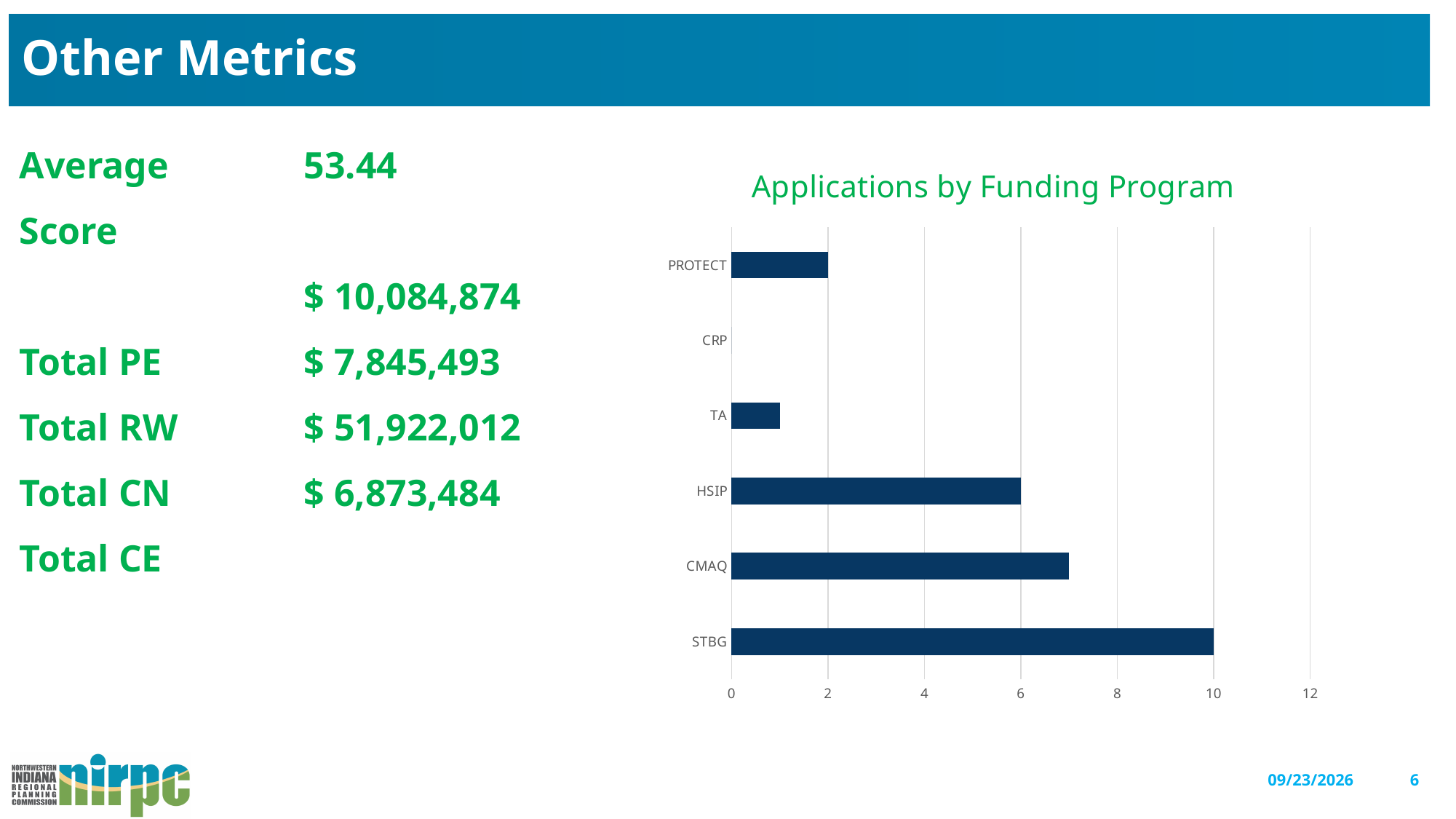
Which funding program has the most applications? STBG Which has more applications, HSIP or CMAQ? CMAQ How many applications does HSIP have? 6 Is the value for TA greater or less than 2? less What kind of chart is shown on the slide? bar chart How many applications does PROTECT have? 2 What is the title of the chart? Applications by Funding Program How many funding programs are listed on the chart? 6 Which funding program has the fewest applications? CRP How many applications does STBG have? 10 How many more applications does STBG have than HSIP? 4 Is the value for CMAQ greater or less than 8? less